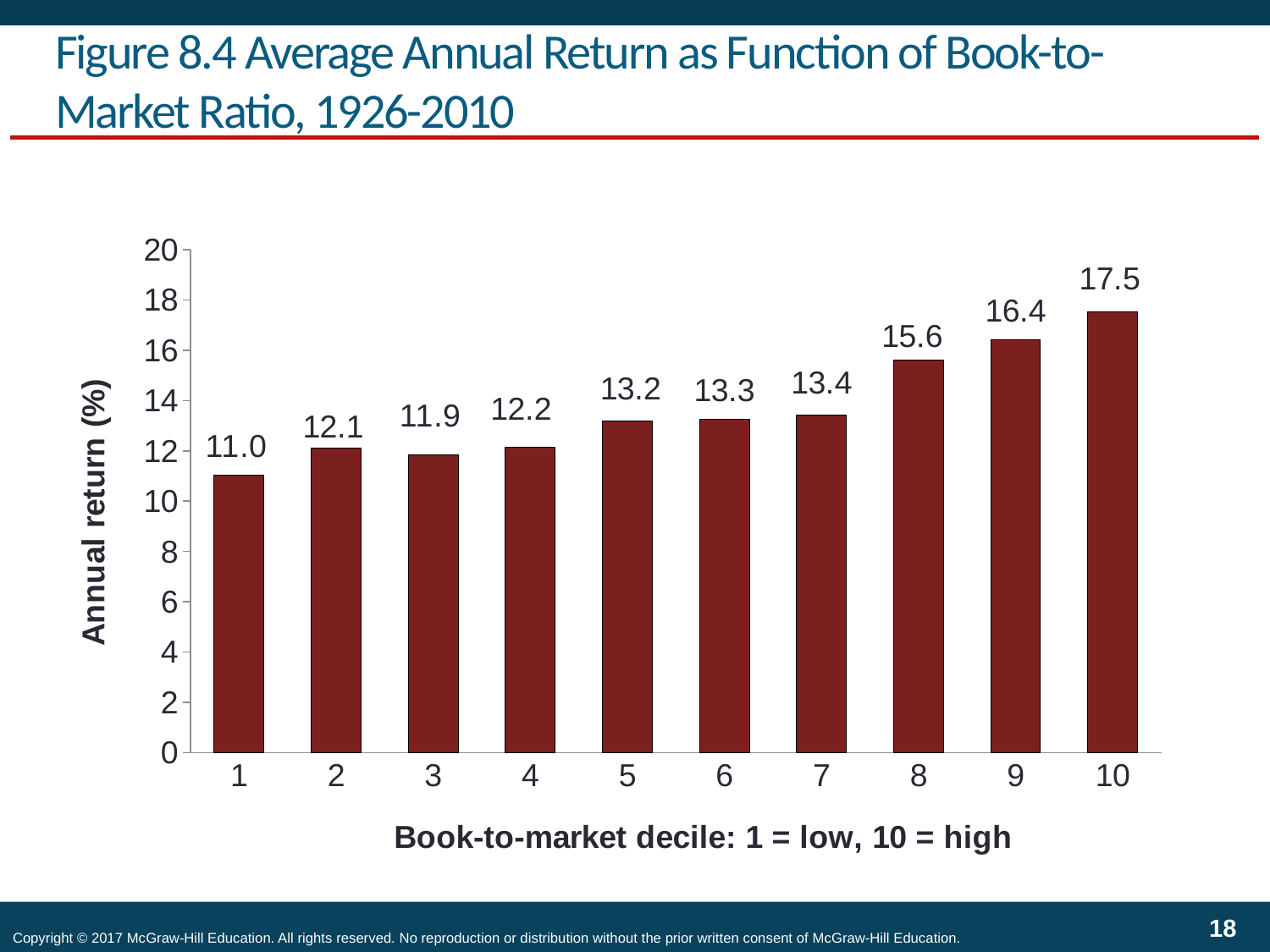
What is the annual return for book-to-market decile 5? 13.2 Is the annual return for decile 9 greater or less than 16? greater What is the label of the vertical axis? Annual return (%) How many book-to-market deciles are shown on the chart? 10 Which book-to-market decile has the highest annual return? 10 What is the annual return for book-to-market decile 1? 11.0 Which has a higher annual return, decile 2 or decile 3? Decile 2 What kind of chart is shown on the slide? Bar chart Which book-to-market decile has the lowest annual return? 1 What is the annual return for book-to-market decile 8? 15.6 What is the difference in annual return between decile 10 and decile 1? 6.5 What is the difference in annual return between decile 9 and decile 8? 0.8